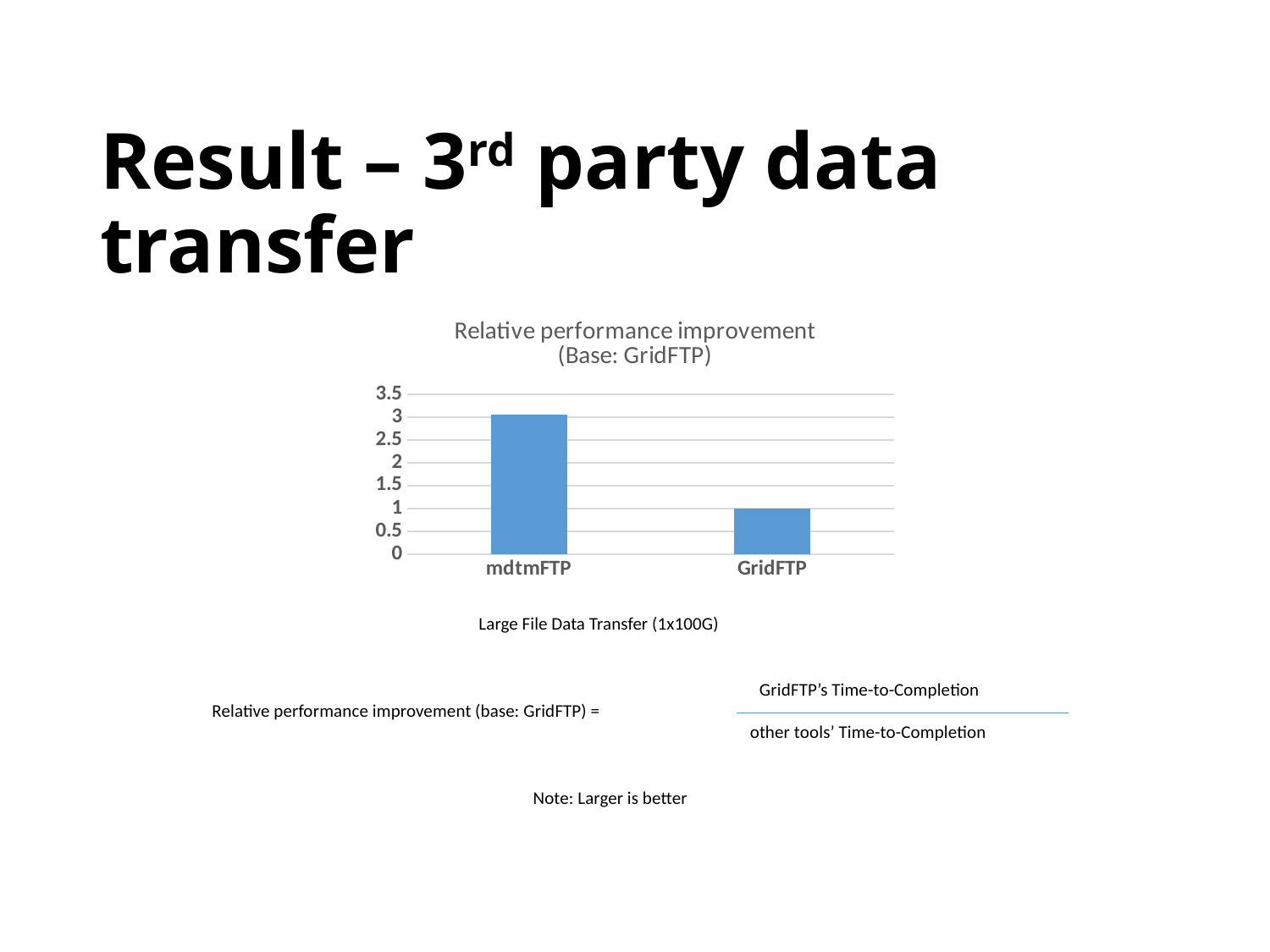
Is the value for mdtmFTP greater or less than 2.5? greater Which has a larger value, mdtmFTP or GridFTP? mdtmFTP Do the values rise or fall from mdtmFTP to GridFTP along the x axis? fall What kind of chart is shown on the slide? bar chart What is the highest value shown on the y axis? 3.5 What is the title of the chart? Relative performance improvement (Base: GridFTP) Is the value for GridFTP greater or less than 2? less How many categories are plotted in the chart? 2 Which category has the highest relative performance improvement? mdtmFTP What is the relative performance improvement value for GridFTP? 1 Which category has the lowest relative performance improvement? GridFTP Is the value for mdtmFTP greater or less than 3.5? less